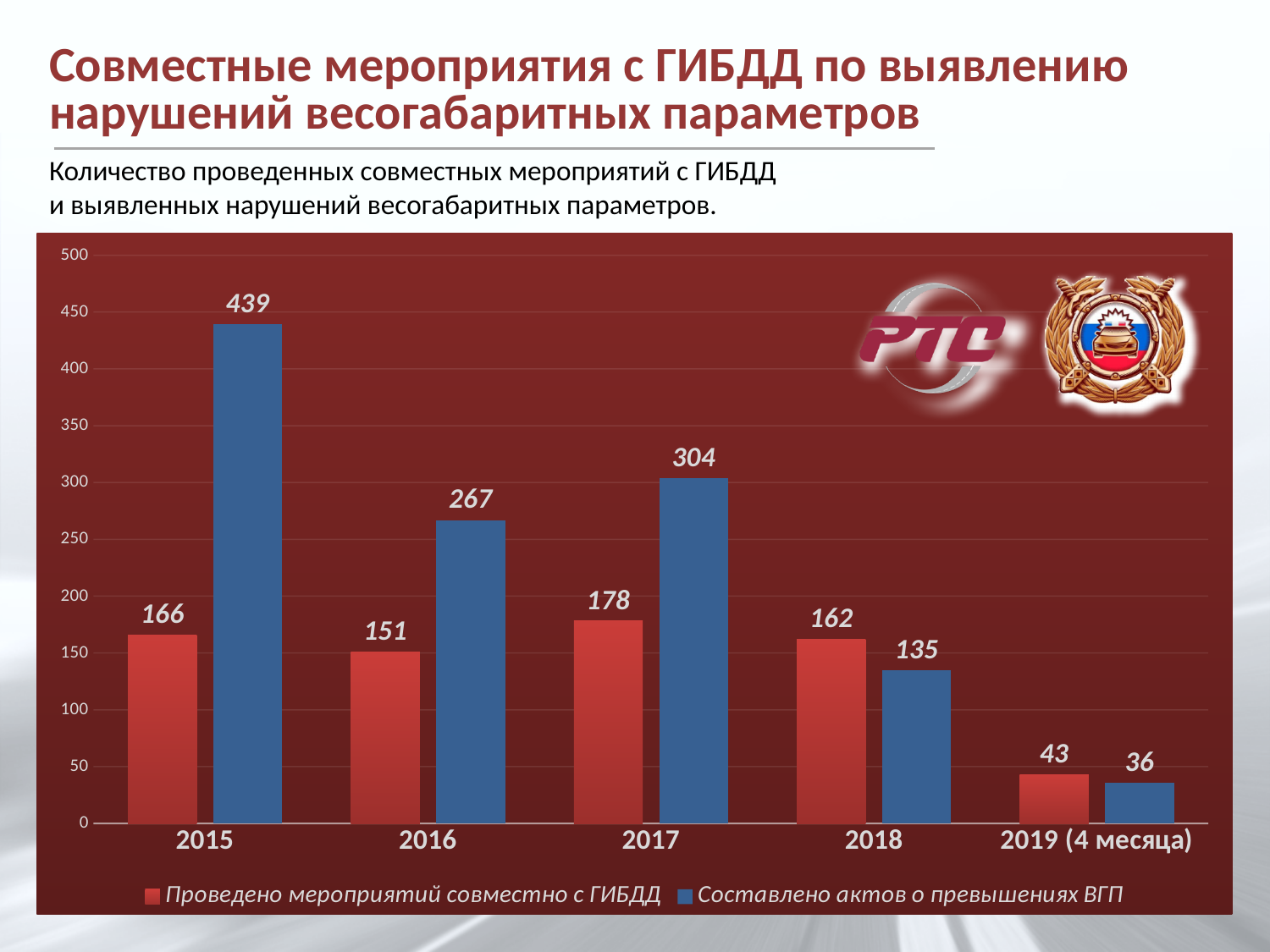
How many categories are shown on the x axis? 5 Which category has the lowest value for joint events held with ГИБДД? 2019 (4 месяца) In 2018, which is larger: the number of joint events held or the number of acts drawn up? Проведено мероприятий совместно с ГИБДД (162) What is the total of the two values shown for 2019 (4 месяца)? 79 How many joint events with ГИБДД (Проведено мероприятий совместно с ГИБДД) were held in 2017? 178 In which year was the number of acts drawn up (Составлено актов о превышениях ВГП) the highest? 2015 What is the difference between the number of acts drawn up and the number of joint events held in 2016? 116 Which colour represents the series 'Составлено актов о превышениях ВГП'? Blue Does the number of acts drawn up (Составлено актов о превышениях ВГП) rise or fall from 2017 to 2019 (4 месяца)? Fall What kind of chart is shown on the slide? Bar chart How many series does the legend list? 2 How many acts on exceeding weight and size parameters (Составлено актов о превышениях ВГП) were drawn up in 2015? 439